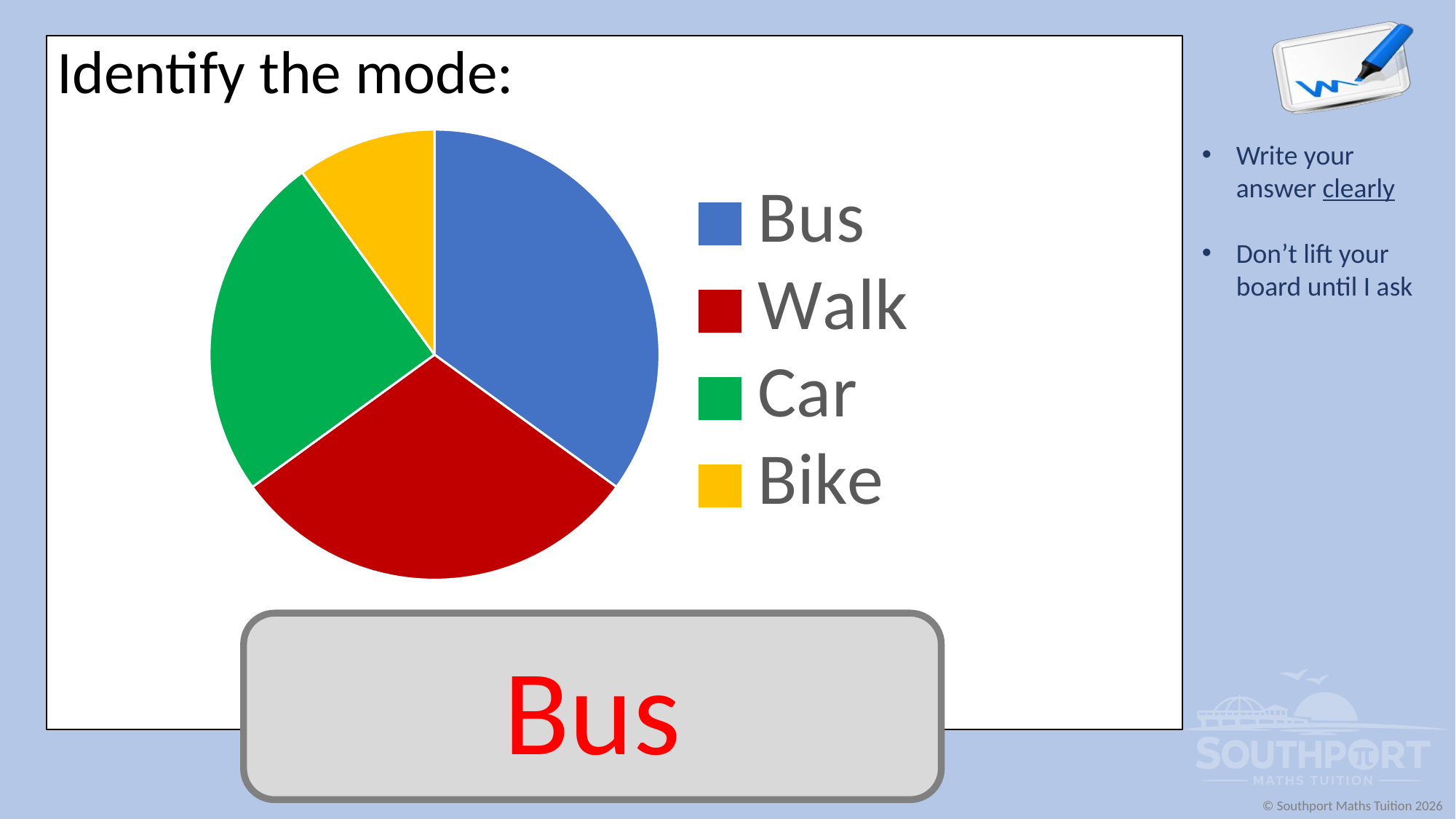
Which slice is larger, Walk or Car? Walk Which slice is larger, Bus or Bike? Bus How many slices does the pie chart have? 4 What kind of chart is shown on the slide? pie chart How many entries does the legend list? 4 Which category has the smallest slice of the pie chart? Bike According to the slide, what is the mode of the data in the pie chart? Bus Which category is shown in yellow in the pie chart? Bike Which slice is larger, Car or Bike? Car Which category has the largest slice of the pie chart? Bus What colour is the Bus slice in the pie chart? blue